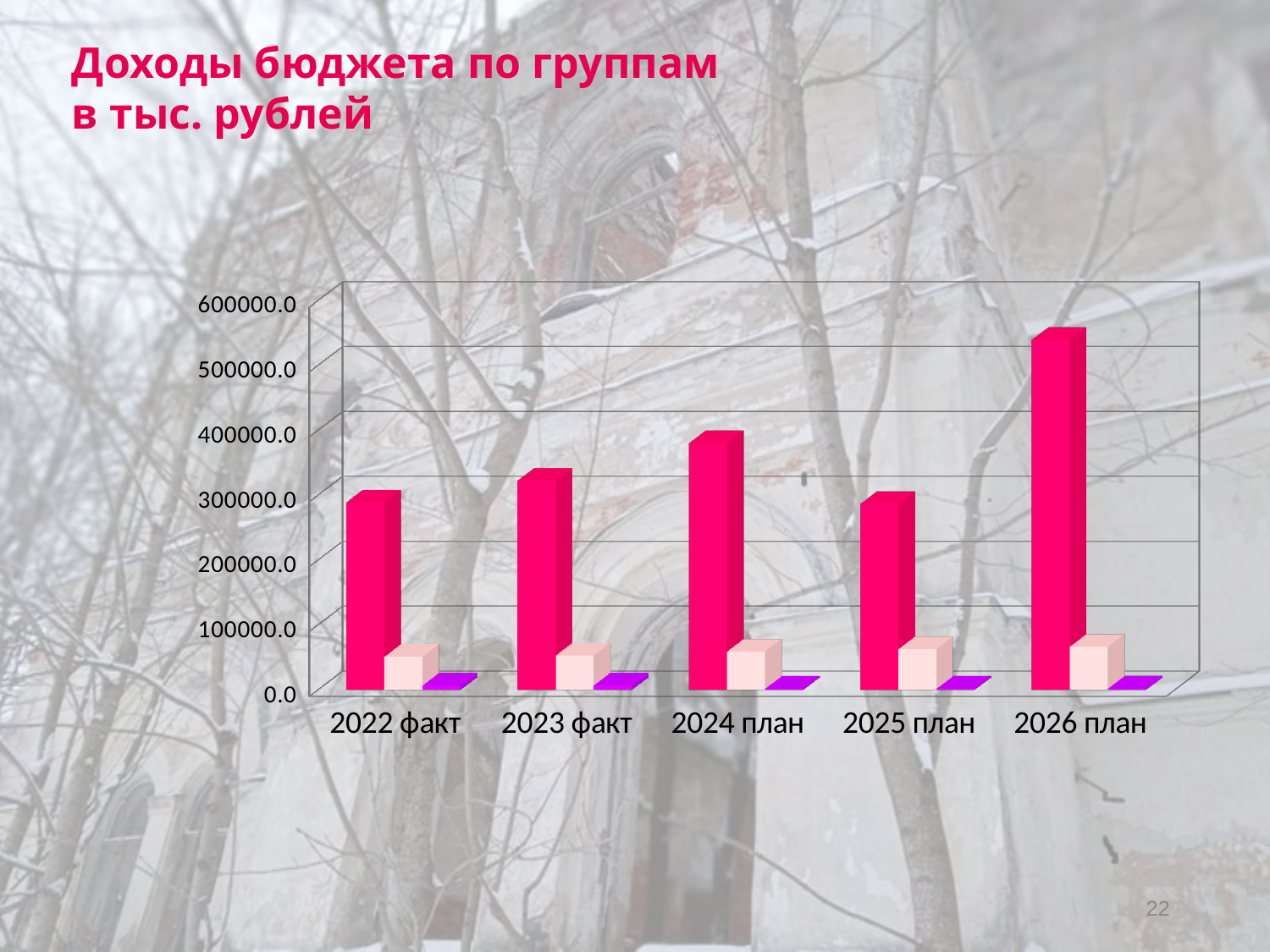
Which is larger, the tallest bar for 2026 план or the tallest bar for 2024 план? 2026 план Is the value of the tallest bar for 2023 факт greater or less than 300000.0? greater Which is larger, the tallest bar for 2024 план or the tallest bar for 2023 факт? 2024 план How many bars are plotted for each category in the chart? 3 What kind of chart is shown on the slide? bar chart Is the value of the tallest bar for 2024 план greater or less than 300000.0? greater How many categories are shown on the x axis of the chart? 5 Which is larger, the tallest bar for 2024 план or the tallest bar for 2025 план? 2024 план Is the value of the light pink bar for 2026 план greater or less than 100000.0? less Which category has the tallest pink bar in the chart? 2026 план What is the title of the slide containing the chart? Доходы бюджета по группам в тыс. рублей